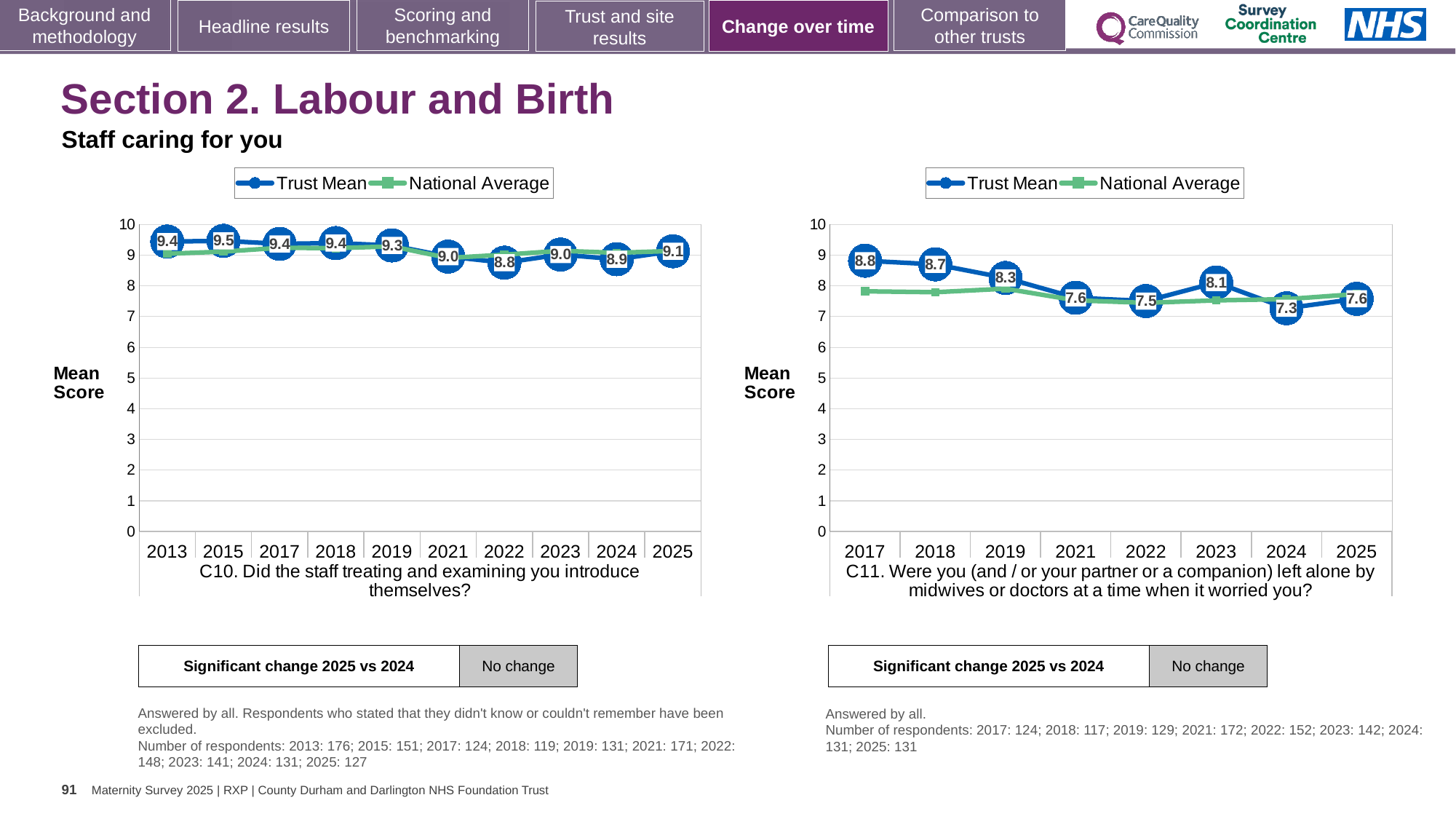
In the C11 chart on the right, which year has the highest Trust Mean score? 2017 In the C11 chart on the right, what is the difference between the Trust Mean scores for 2017 and 2025? 1.2 In the C11 chart on the right, does the Trust Mean score rise or fall from 2017 to 2021? Fall What type of chart is the C11 chart on the right? Line chart In the C11 chart on the right, which year has the lowest Trust Mean score? 2024 How many series does the legend of the C10 chart on the left list? 2 In the C10 chart on the left, which year has the highest Trust Mean score? 2015 In the C11 chart on the right, what is the Trust Mean score for 2021? 7.6 In the C10 chart on the left, which year has the lowest Trust Mean score? 2022 In the C10 chart on the left, what is the Trust Mean score for 2025? 9.1 How many years are plotted on the x axis of the C11 chart on the right? 8 In the C10 chart on the left, is the Trust Mean score higher in 2023 or in 2024? 2023